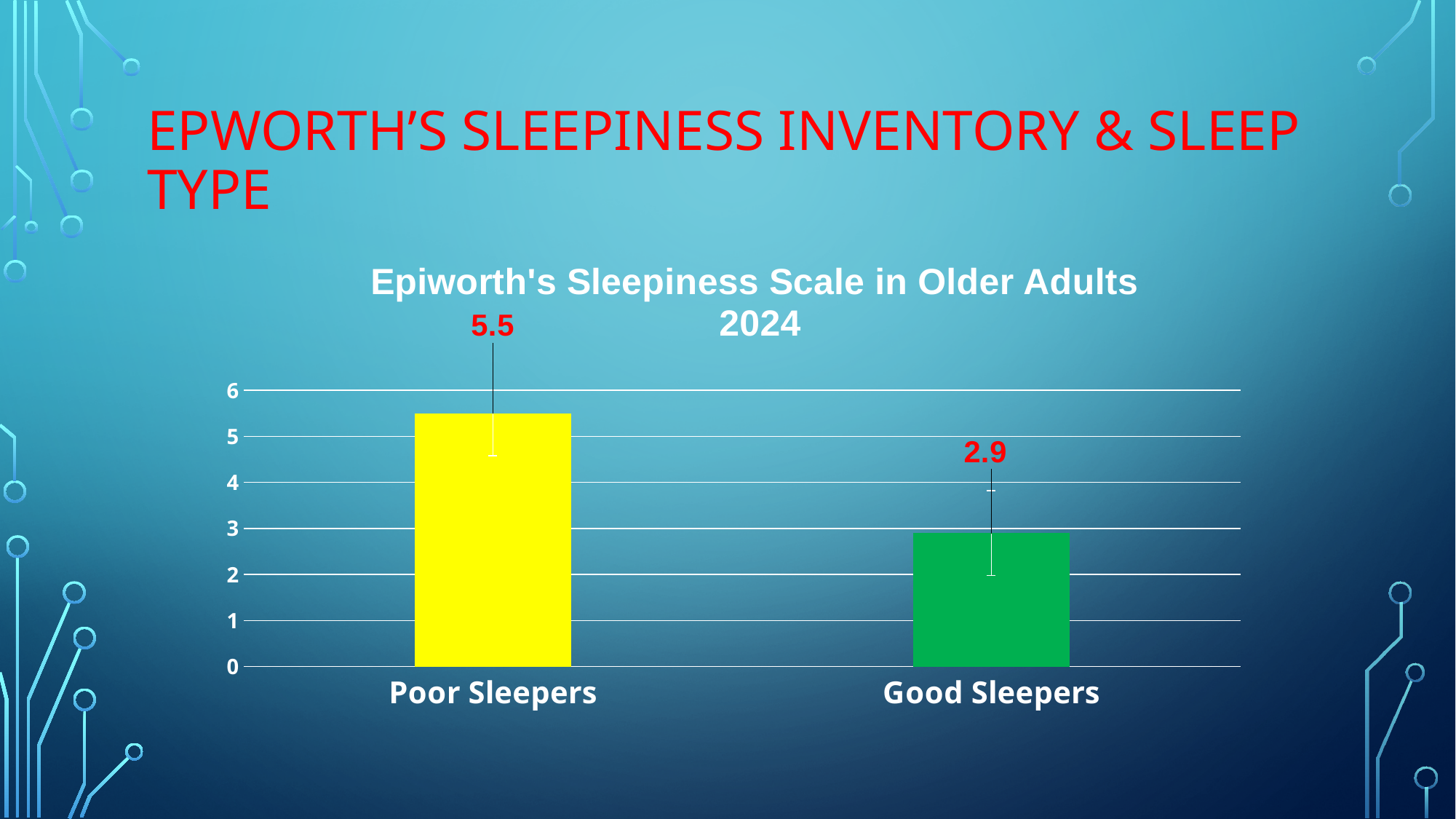
What is the title of the chart? Epiworth's Sleepiness Scale in Older Adults 2024 What is the value for Good Sleepers? 2.9 Which is larger, the value for Poor Sleepers or the value for Good Sleepers? Poor Sleepers Which category has the highest value? Poor Sleepers Which category has the lowest value? Good Sleepers Is the value for Poor Sleepers greater or less than 5? greater Is the value for Good Sleepers greater or less than 3? less How many categories are shown on the x axis? 2 What colour is the bar for Good Sleepers? green What is the value for Poor Sleepers? 5.5 What kind of chart is shown on the slide? bar chart What is the difference between the values for Poor Sleepers and Good Sleepers? 2.6